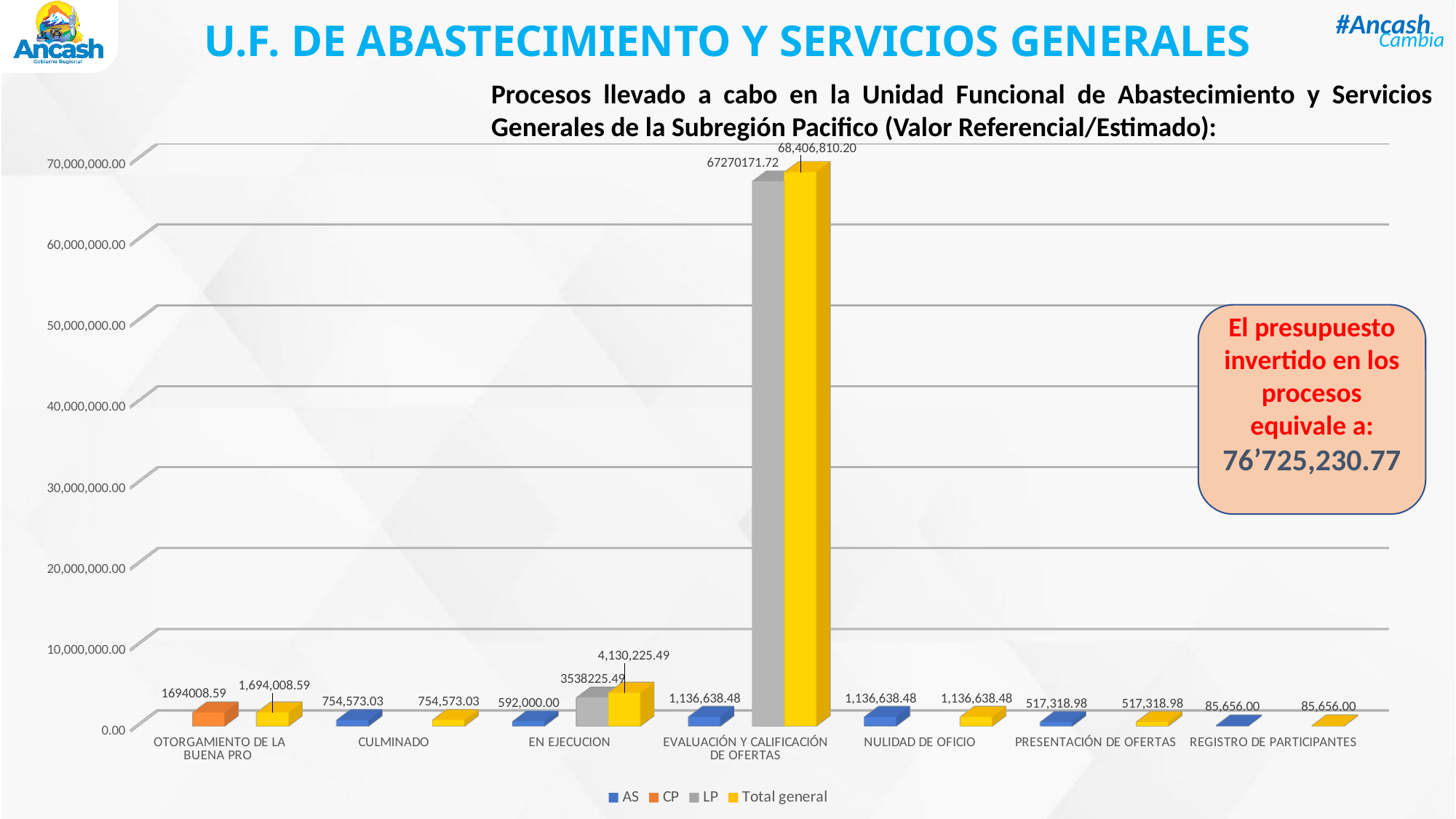
What is the CP value for OTORGAMIENTO DE LA BUENA PRO? 1694008.59 What is the AS value for PRESENTACIÓN DE OFERTAS? 517,318.98 How many series does the legend list? 4 How many categories are shown on the x axis? 7 Which category has the lowest Total general value? REGISTRO DE PARTICIPANTES Is the LP value for EVALUACIÓN Y CALIFICACIÓN DE OFERTAS greater or less than 60,000,000.00? greater What is the Total general value for EVALUACIÓN Y CALIFICACIÓN DE OFERTAS? 68,406,810.20 Which category has the highest Total general value? EVALUACIÓN Y CALIFICACIÓN DE OFERTAS What kind of chart is shown on the slide? bar chart Which is larger: the AS value for CULMINADO or the AS value for NULIDAD DE OFICIO? NULIDAD DE OFICIO What is the LP value for EN EJECUCION? 3538225.49 What is the difference between the Total general value and the LP value for EN EJECUCION? 592,000.00